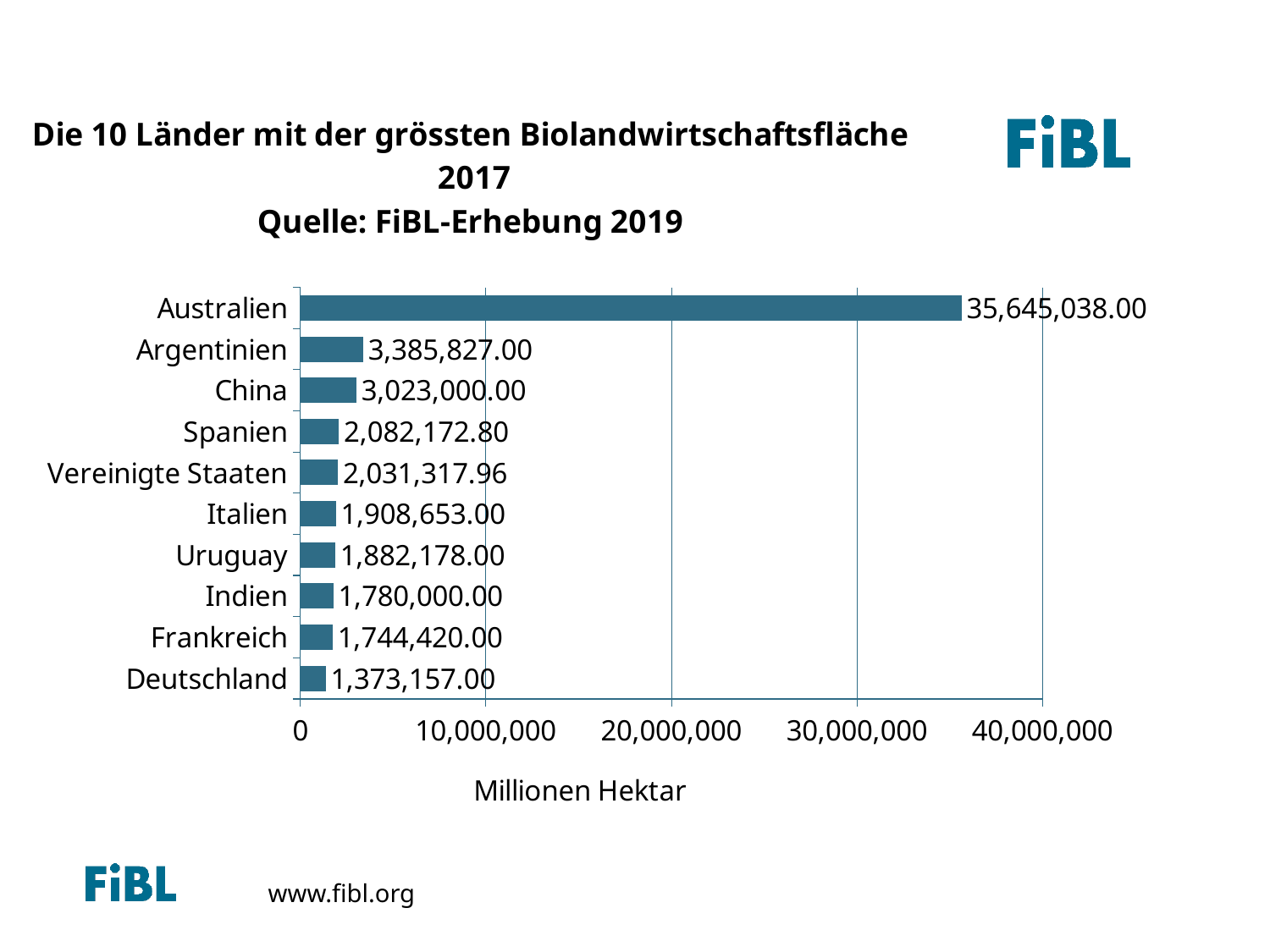
Which is larger, the value for Argentinien or the value for Deutschland? Argentinien What is the value for Australien? 35,645,038.00 Which country has the smallest value on the chart? Deutschland How many countries are shown on the chart? 10 What kind of chart is shown on the slide? bar chart Is the value for Australien greater or less than 30,000,000? greater What is the value for Vereinigte Staaten? 2,031,317.96 Which country has the largest organic agricultural area? Australien What is the value for Spanien? 2,082,172.80 What is the difference between the values for Argentinien and China? 362,827.00 What is the difference between the values for Indien and Frankreich? 35,580.00 What is the value for Deutschland? 1,373,157.00